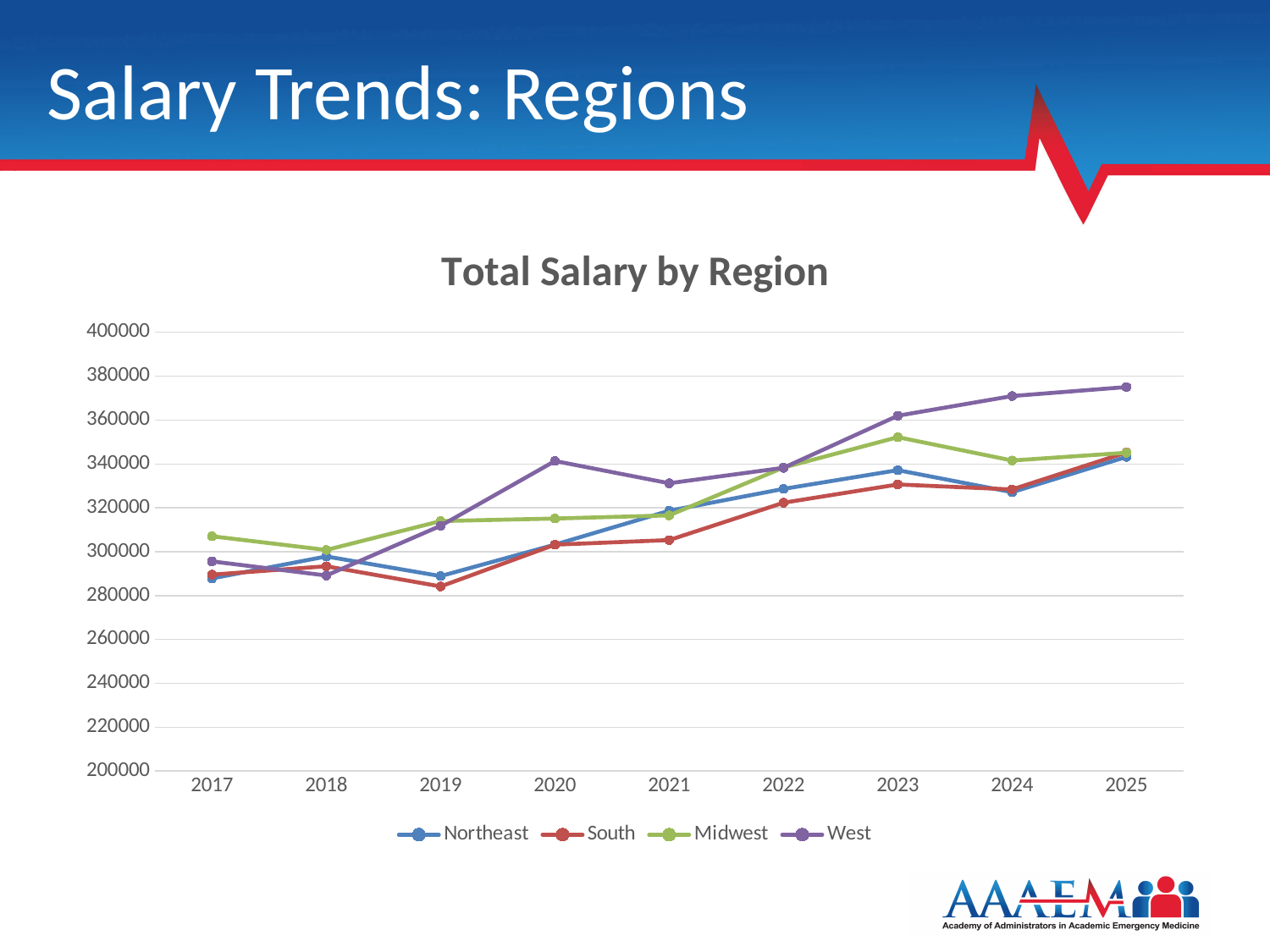
How many series does the legend list? 4 How many years are plotted along the x axis? 9 What is the title of the chart? Total Salary by Region Which region has the lowest total salary in 2019? South Is the value for Midwest in 2023 greater or less than 340000? greater Which region has the highest total salary in 2025? West Does the West line rise or fall from 2022 to 2025? rise Which region has the highest total salary in 2017? Midwest Is the value for West in 2025 greater or less than 360000? greater Is the value for South in 2019 greater or less than 300000? less In 2023, which is larger: the value for West or the value for Northeast? West What kind of chart is shown on the slide? Line chart